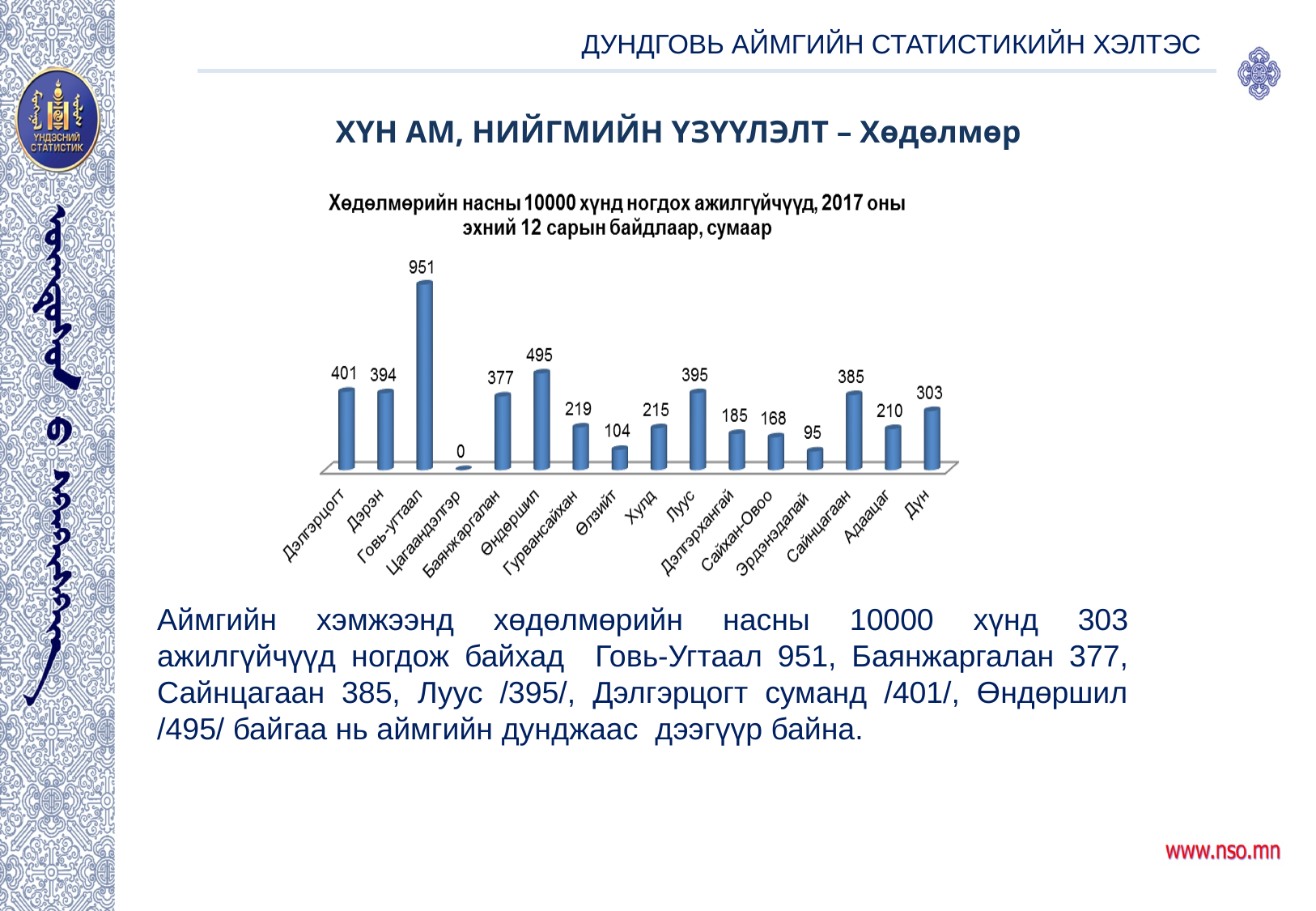
Which category has the lowest value? Цагаандэлгэр Which is larger, the value for Луус or the value for Дэрэн? Луус How many categories are shown on the x axis? 16 What is the value for Дүн? 303 What is the difference between the values for Сайнцагаан and Адаацаг? 175 What is the value for Эрдэнэдалай? 95 What kind of chart is shown on the slide? Bar chart What is the value for Говь-Угтаал? 951 Which is larger, the value for Хулд or the value for Өлзийт? Хулд What is the difference between the values for Говь-Угтаал and Өндөршил? 456 Which category has the highest value? Говь-Угтаал What is the value for Өндөршил? 495